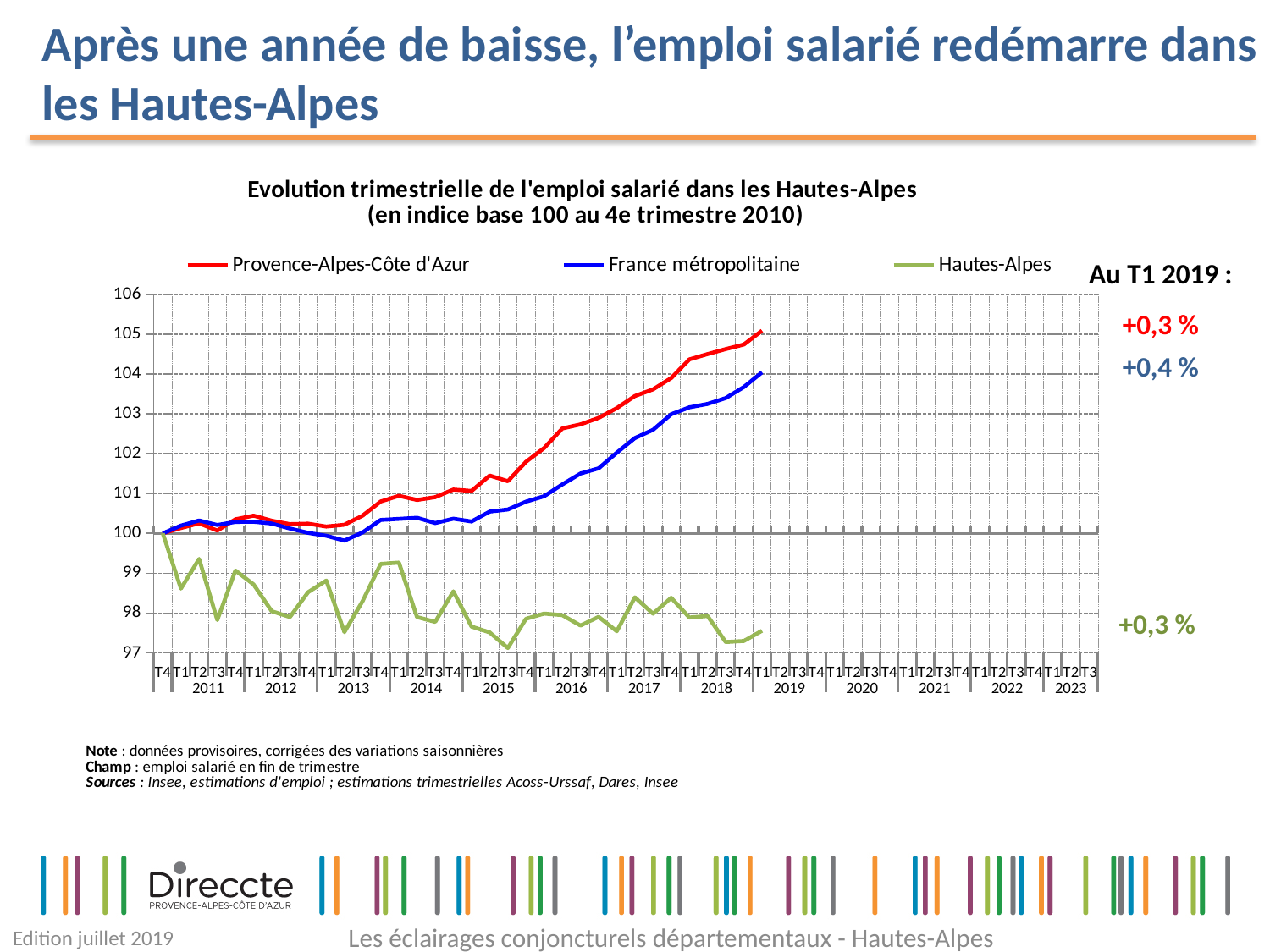
What quarterly change is annotated for France métropolitaine at T1 2019? +0,4 % What quarterly change is annotated for Provence-Alpes-Côte d'Azur at T1 2019? +0,3 % What quarterly change is annotated for Hautes-Alpes at T1 2019? +0,3 % Which series has the lowest value at T1 2019? Hautes-Alpes What is the title of the chart? Evolution trimestrielle de l'emploi salarié dans les Hautes-Alpes (en indice base 100 au 4e trimestre 2010) Is the value for Provence-Alpes-Côte d'Azur at T1 2019 greater or less than 104? greater What is the index value of all three series at T4 2010, the base quarter? 100 How many series does the chart legend list? 3 Is the value for Hautes-Alpes at T1 2019 greater or less than 98? less What kind of chart is shown on the slide? line chart Does the Provence-Alpes-Côte d'Azur series rise or fall overall from T4 2010 to T1 2019? rise Which colour is used for the Hautes-Alpes series? green